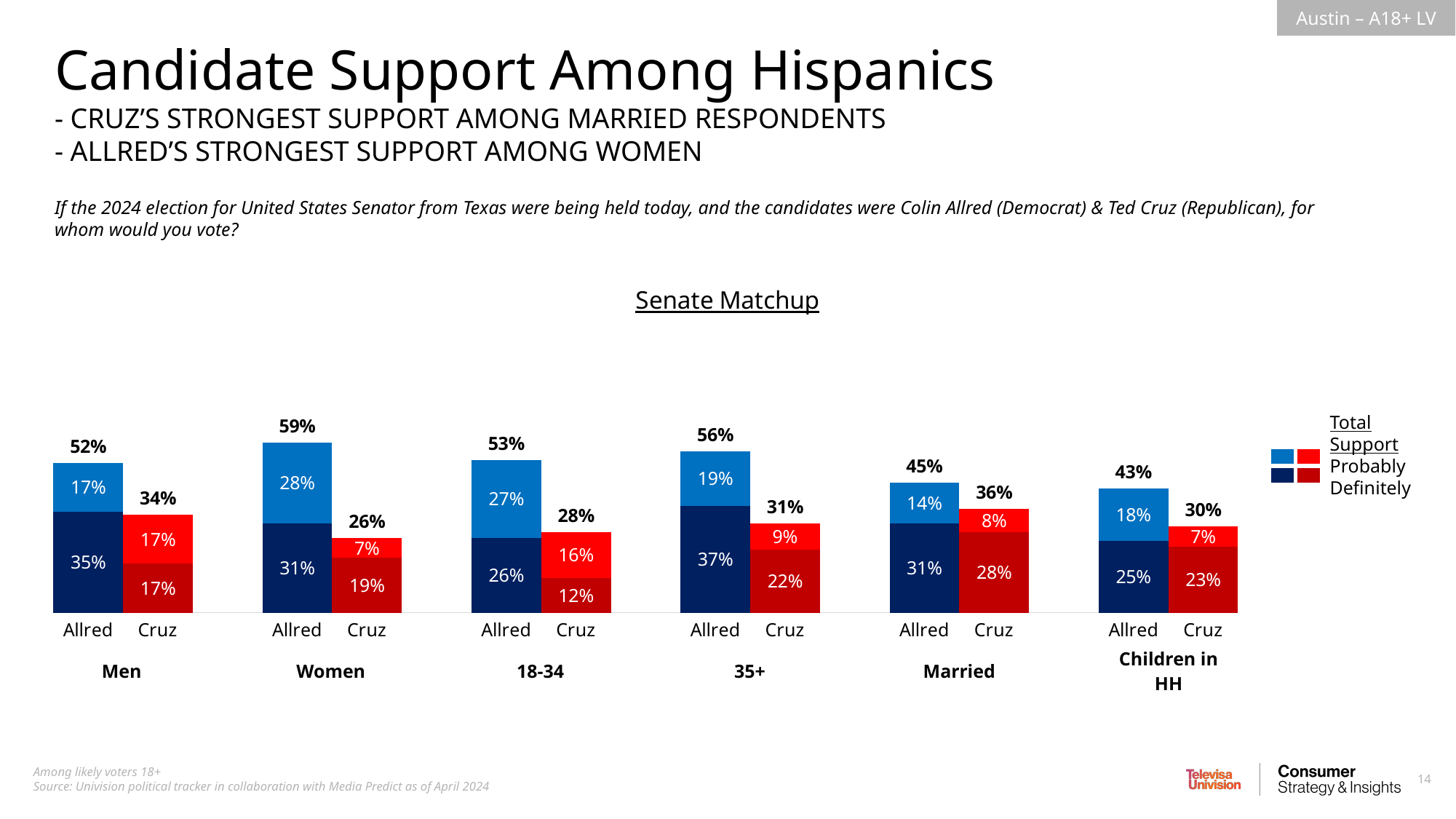
What is the 'Probably' share for Allred among 18-34 respondents? 27% In which demographic group is Allred's total support lowest? Children in HH What two levels of support does the legend distinguish? Probably and Definitely In which demographic group is Cruz's total support highest? Married What is the total support for Allred among Women? 59% Among Men, how many percentage points higher is Allred's total support than Cruz's? 18 percentage points Among Women, how many percentage points higher is Allred's 'Definitely' share than his 'Probably' share? 3 percentage points What is the total support for Cruz among 18-34 respondents? 28% Which is larger: Allred's 'Definitely' share among 35+ respondents or among Married respondents? 35+ How many demographic groups are shown in the Senate Matchup chart? 6 What share of Married respondents say they would 'Definitely' vote for Cruz? 28% What kind of chart is the Senate Matchup chart? Stacked bar chart